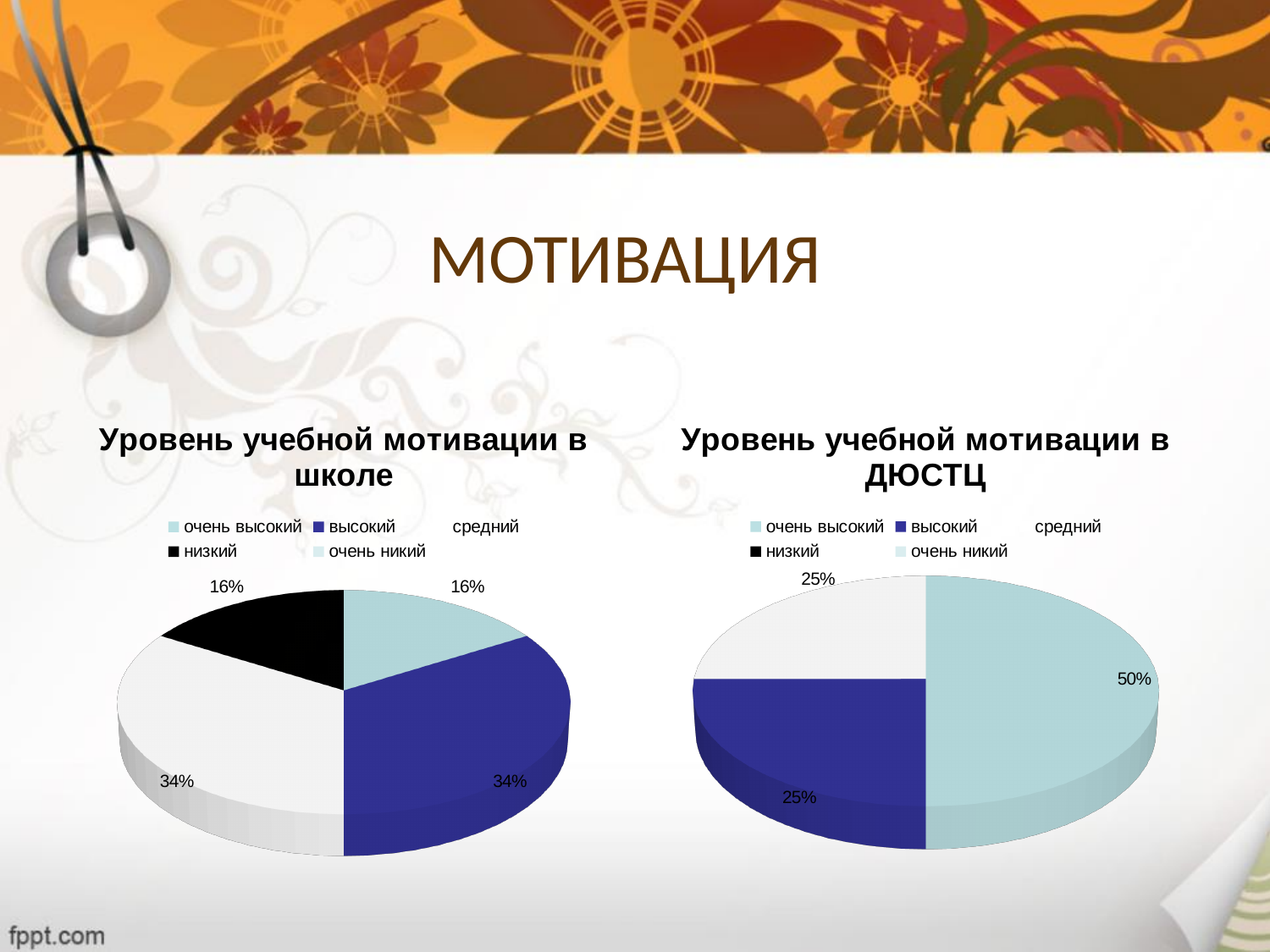
In the chart "Уровень учебной мотивации в школе", how many slices have a percentage label? 4 What kind of chart is used for "Уровень учебной мотивации в школе"? pie chart In the chart "Уровень учебной мотивации в школе", what share is labelled for the "очень высокий" slice? 16% In the chart "Уровень учебной мотивации в ДЮСТЦ", which category has the largest slice? очень высокий In the chart "Уровень учебной мотивации в школе", what share is labelled for the "низкий" slice? 16% In the chart "Уровень учебной мотивации в ДЮСТЦ", how many slices have a percentage label? 3 How many entries does the legend of the chart "Уровень учебной мотивации в школе" list? 5 In the chart "Уровень учебной мотивации в ДЮСТЦ", what share is labelled for the "очень высокий" slice? 50% Which chart has the larger share for "очень высокий": "Уровень учебной мотивации в школе" or "Уровень учебной мотивации в ДЮСТЦ"? Уровень учебной мотивации в ДЮСТЦ In the chart "Уровень учебной мотивации в ДЮСТЦ", what share is labelled for the "высокий" slice? 25% In the chart "Уровень учебной мотивации в школе", what is the difference between the "высокий" share and the "низкий" share? 18% In the chart "Уровень учебной мотивации в школе", what share is labelled for the "высокий" slice? 34%